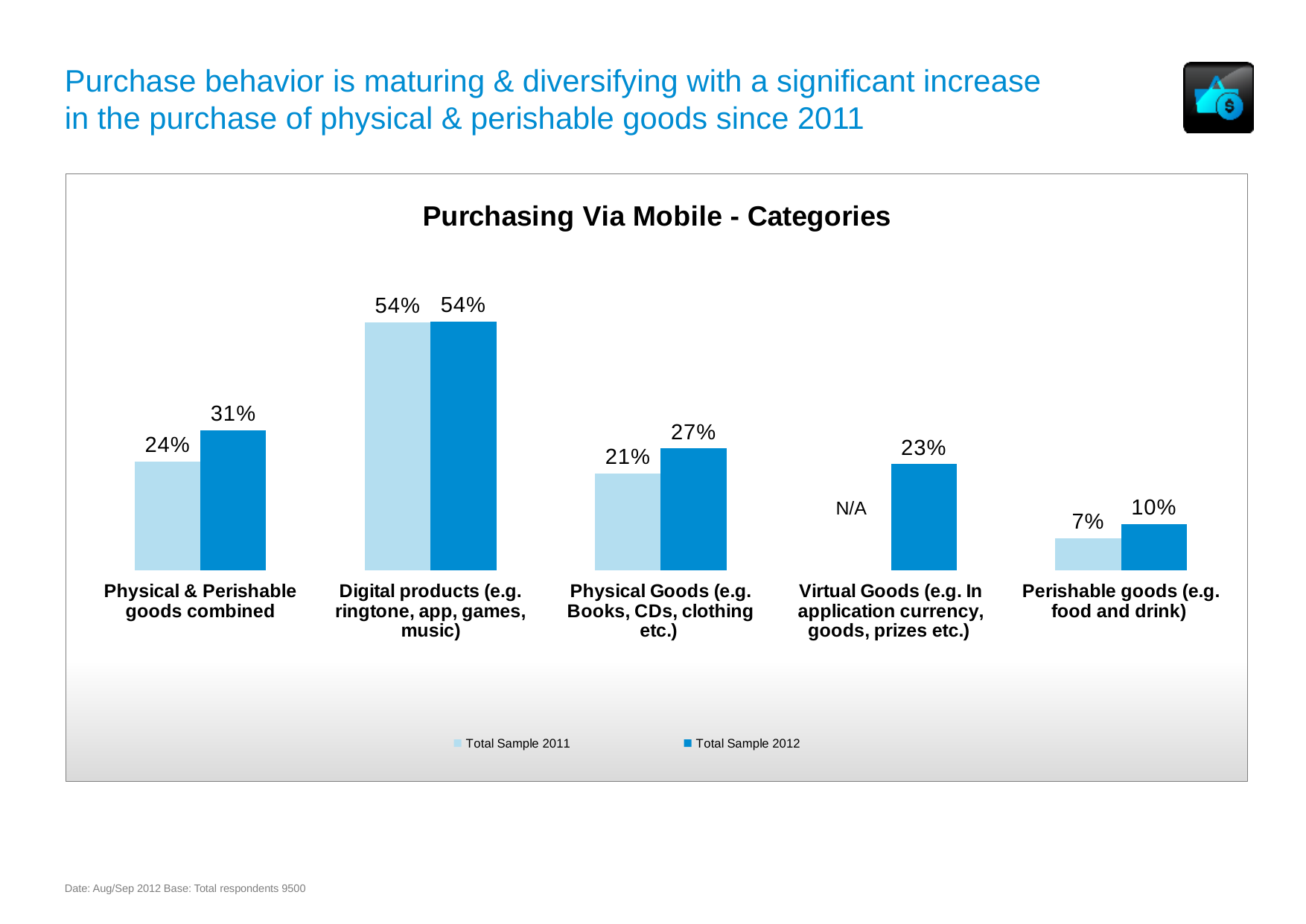
What is the Total Sample 2011 value for Perishable goods (e.g. food and drink)? 7% Which category has the highest Total Sample 2012 value? Digital products (e.g. ringtone, app, games, music) What is the Total Sample 2011 value for Digital products (e.g. ringtone, app, games, music)? 54% What kind of chart is shown on the slide? Bar chart What is shown as the Total Sample 2011 value for Virtual Goods (e.g. In application currency, goods, prizes etc.)? N/A What is the difference between the Total Sample 2012 and Total Sample 2011 values for Physical Goods (e.g. Books, CDs, clothing etc.)? 6% How many categories are shown on the x axis of the chart? 5 Which is larger for Physical & Perishable goods combined: the Total Sample 2011 value or the Total Sample 2012 value? Total Sample 2012 What is the title of the chart? Purchasing Via Mobile - Categories How many series does the legend list? 2 Which category has the lowest Total Sample 2012 value? Perishable goods (e.g. food and drink) What is the Total Sample 2012 value for Physical & Perishable goods combined? 31%